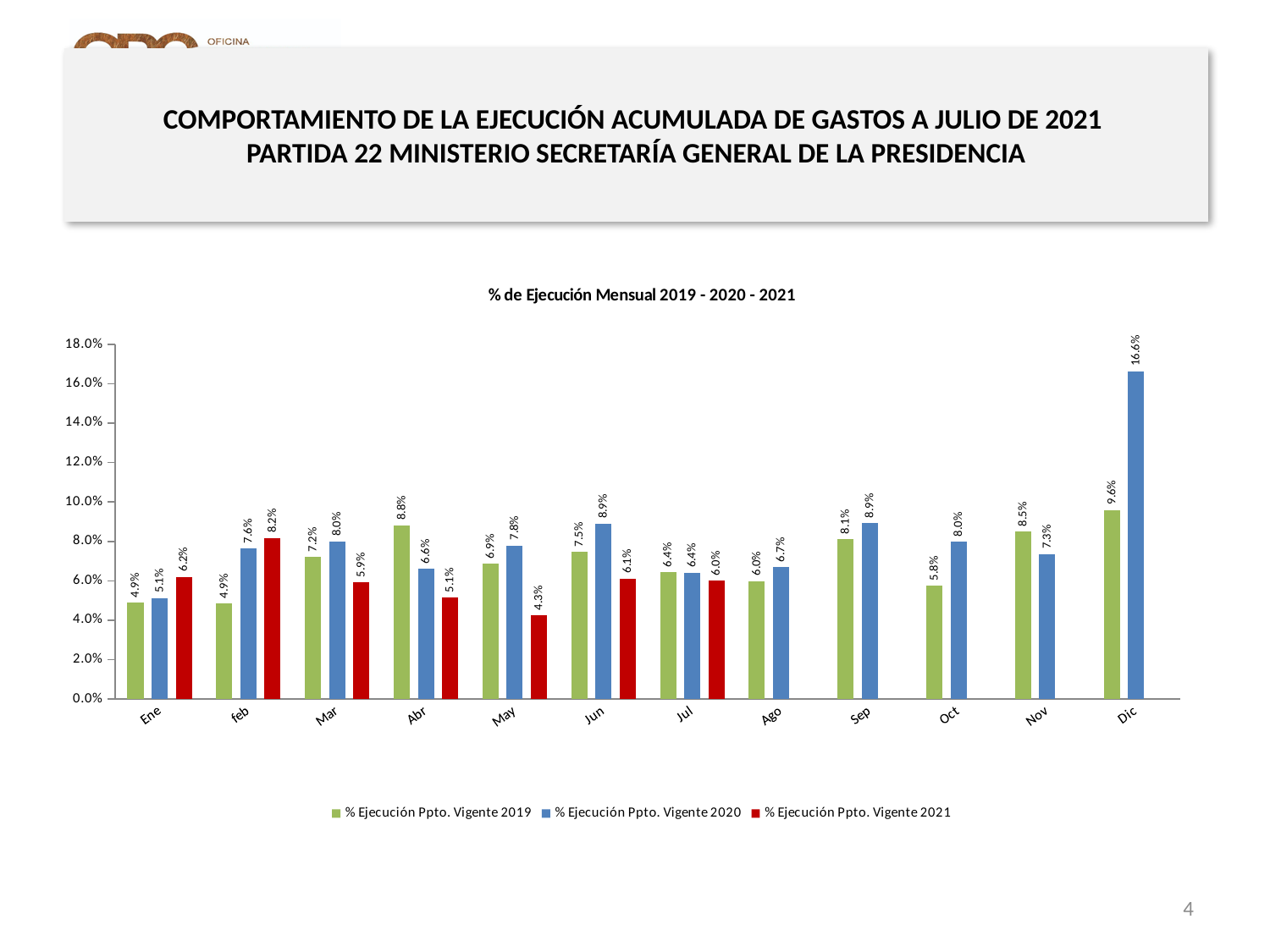
What is the value for % Ejecución Ppto. Vigente 2020 in Dic? 16.6% What kind of chart is shown on the slide? Bar chart How many series does the legend list? 3 Is the value for % Ejecución Ppto. Vigente 2020 in Dic greater or less than 14.0%? greater What is the difference between the 2020 and 2019 values in Dic? 7.0% What is the value for % Ejecución Ppto. Vigente 2019 in Abr? 8.8% What is the title of the chart? % de Ejecución Mensual 2019 - 2020 - 2021 What is the value for % Ejecución Ppto. Vigente 2021 in feb? 8.2% Which is larger in Mar: the 2019 value or the 2021 value? 2019 value (7.2%) Which month has the highest value for % Ejecución Ppto. Vigente 2020? Dic How many months are shown on the x axis? 12 Which month has the lowest value for % Ejecución Ppto. Vigente 2021? May